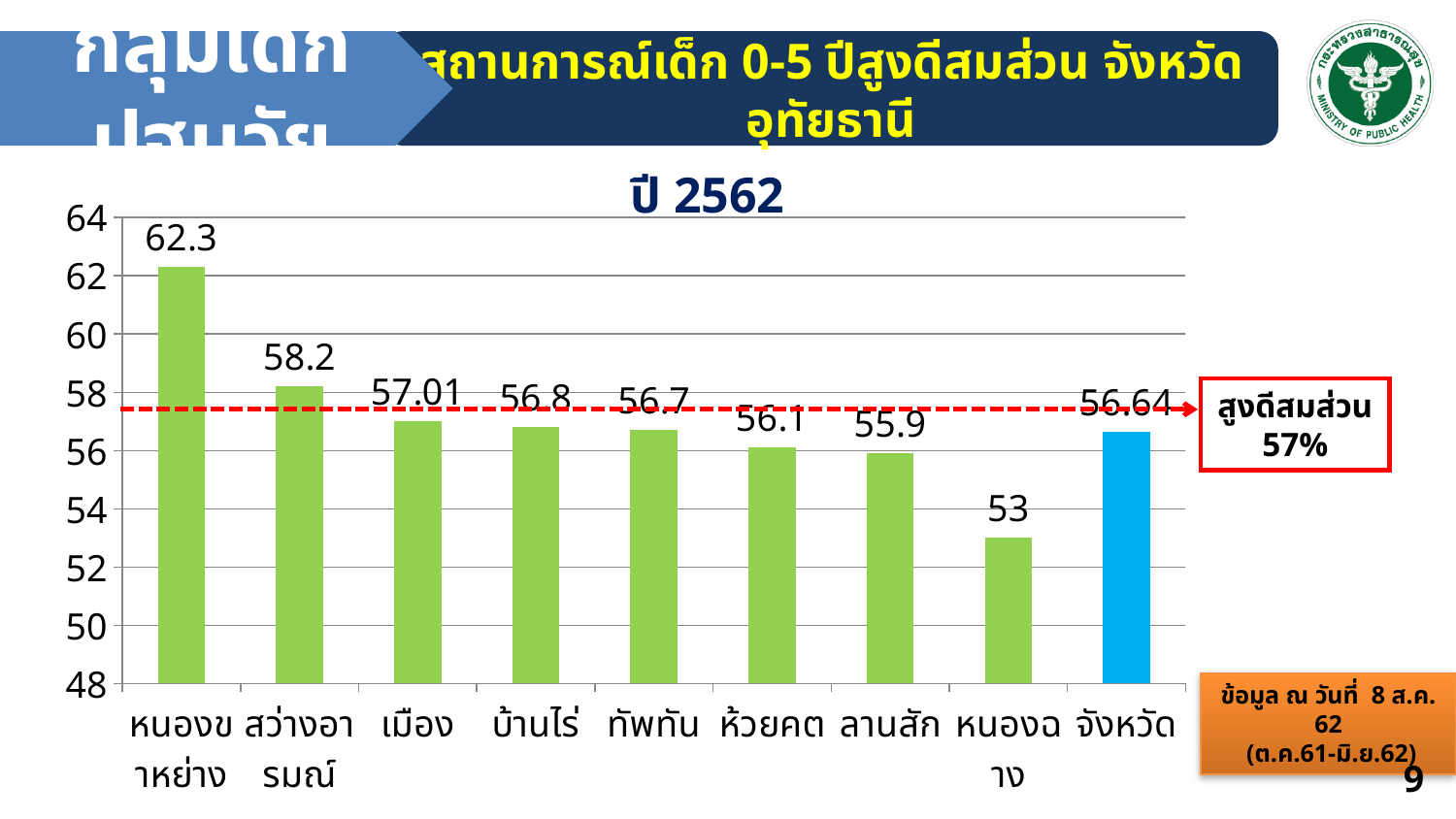
What is the value for จังหวัด? 56.64 Which category has the highest value? หนองขาหย่าง Which is larger, the value for ห้วยคต or the value for ลานสัก? ห้วยคต What is the value for สว่างอารมณ์? 58.2 What is the value for หนองขาหย่าง? 62.3 Is the value for เมือง greater or less than 56? greater Which category has the lowest value? หนองฉาง What is the value for หนองฉาง? 53 How many categories are shown on the x axis? 9 What is the difference between the values for หนองขาหย่าง and สว่างอารมณ์? 4.1 What is the title of the chart? ปี 2562 What kind of chart is shown on the slide? bar chart